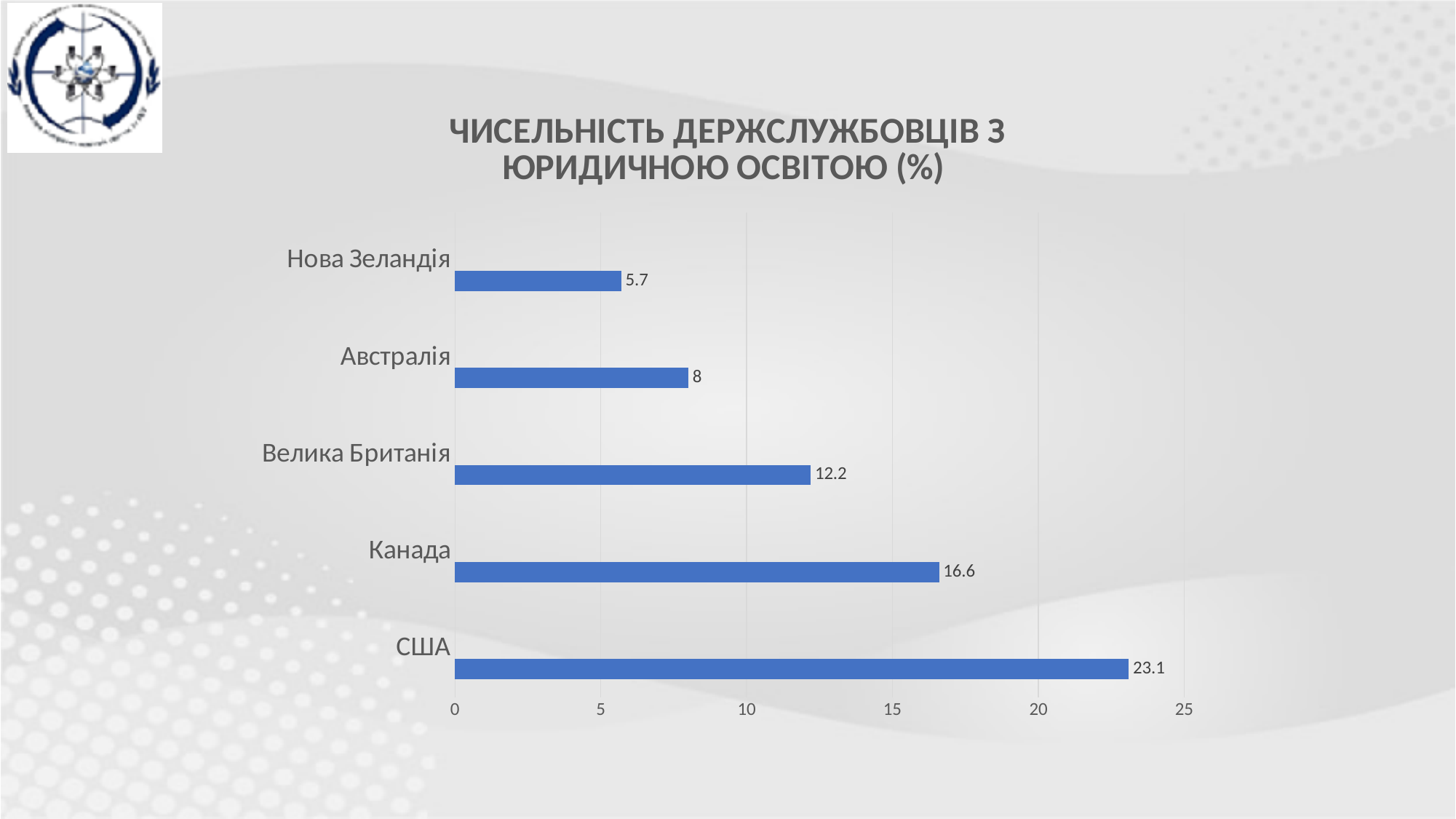
What is the value for Нова Зеландія? 5.7 Which country has the highest value? США Which country has the lowest value? Нова Зеландія What is the value for Канада? 16.6 How many countries are shown in the chart? 5 What is the title of the chart? ЧИСЕЛЬНІСТЬ ДЕРЖСЛУЖБОВЦІВ З ЮРИДИЧНОЮ ОСВІТОЮ (%) What is the value for Австралія? 8 Which has a larger value, Велика Британія or Австралія? Велика Британія What is the value for США? 23.1 What is the difference between the values for США and Канада? 6.5 What kind of chart is shown on the slide? Bar chart What is the value for Велика Британія? 12.2